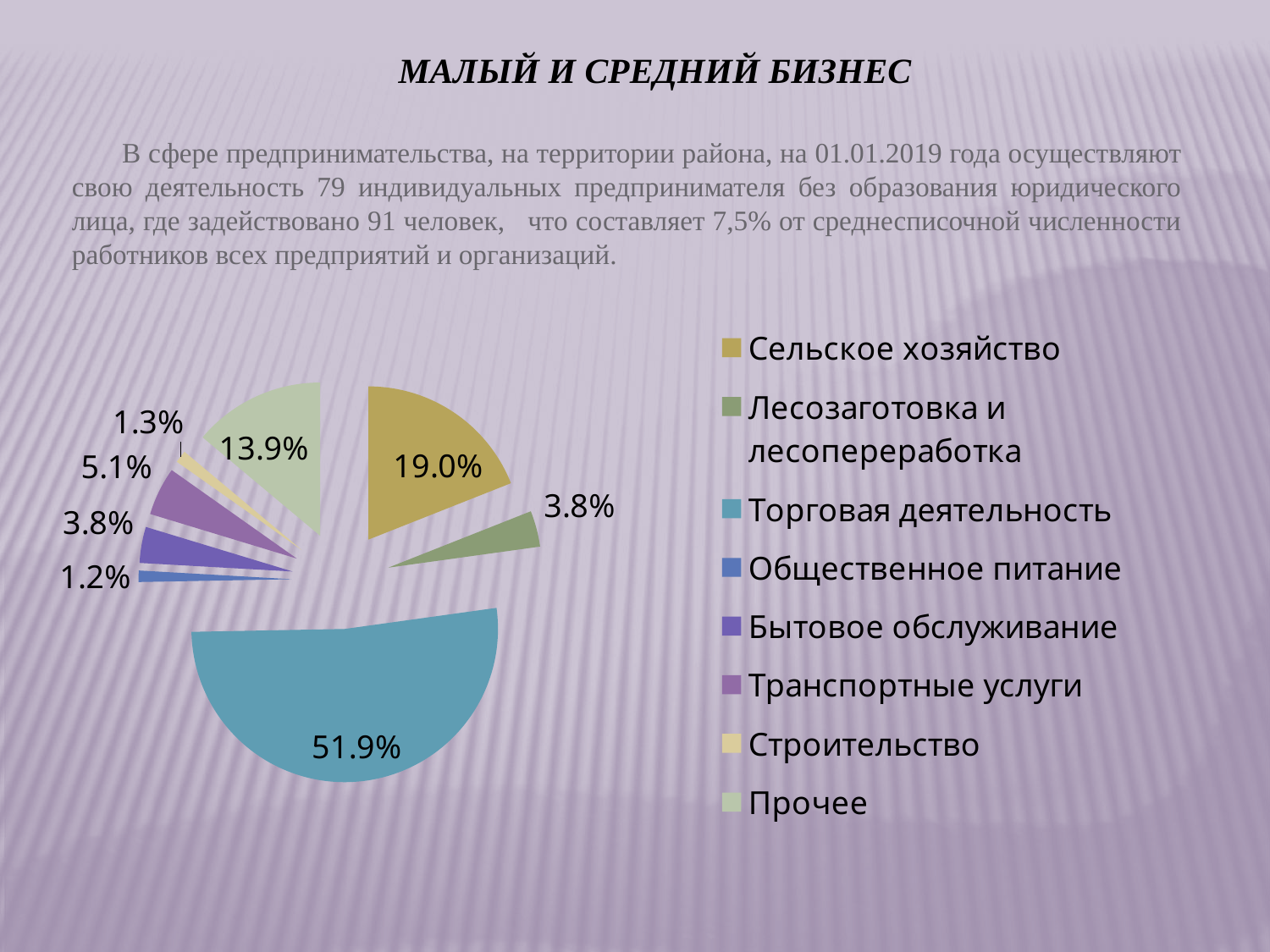
What is the difference between the values for Торговая деятельность and Сельское хозяйство? 32.9% Which category has the largest slice of the pie? Торговая деятельность Which is larger, the value for Прочее or the value for Транспортные услуги? Прочее What is the value for Строительство? 1.3% How many categories does the legend list? 8 What share of the pie does Торговая деятельность have? 51.9% What is the value for Сельское хозяйство? 19.0% What colour is the slice for Торговая деятельность? teal What is the value for Прочее? 13.9% What kind of chart is shown on the slide? pie chart What is the value for Транспортные услуги? 5.1% What is the value for Общественное питание? 1.2%